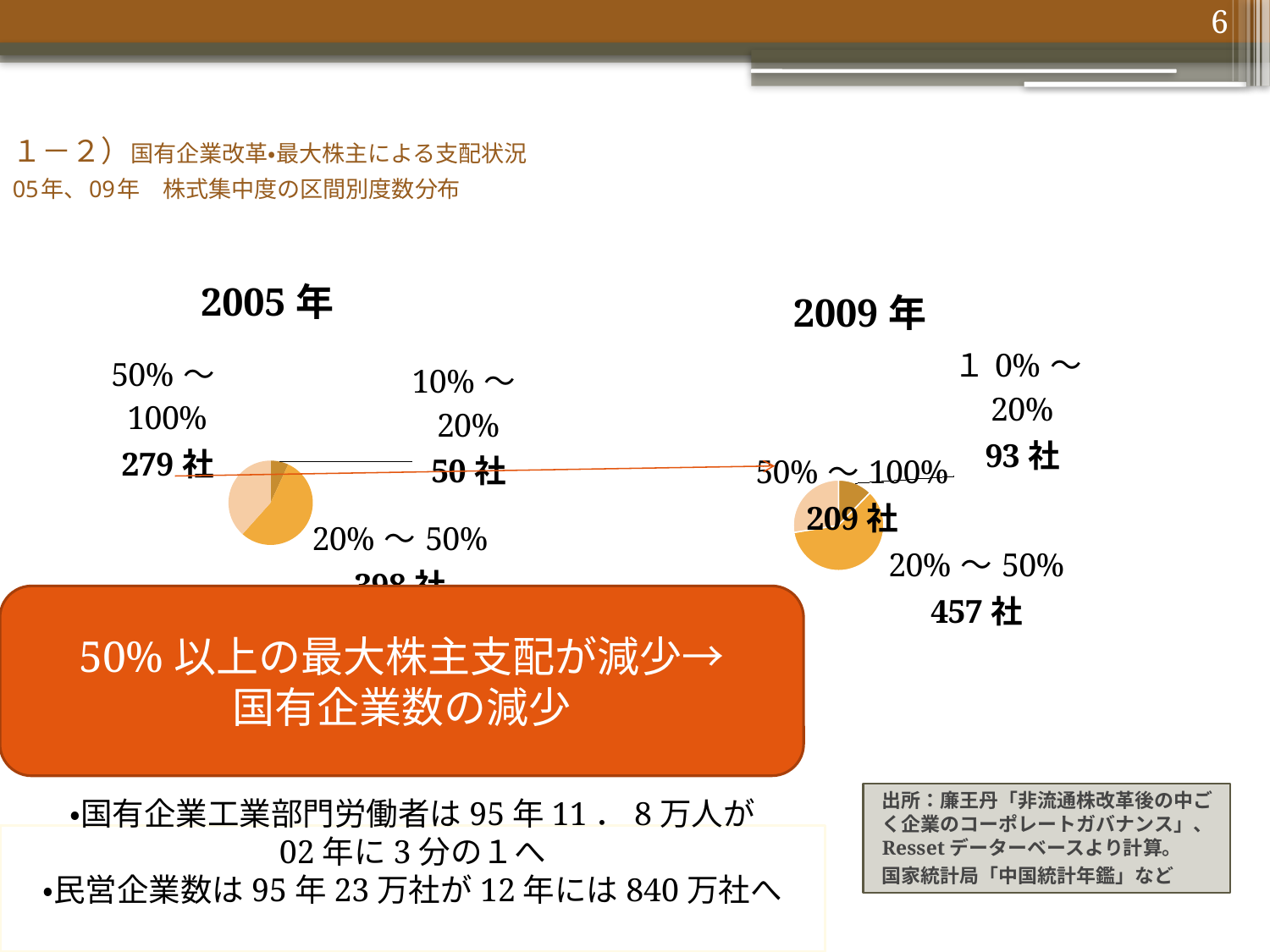
In the 2005年 pie chart, how many companies are in the 50%～100% category? 279社 Which is larger: the 50%～100% category in the 2005年 chart or the 50%～100% category in the 2009年 chart? 2005年 (279社) What kind of chart is used for the 2009年 data? Pie chart In the 2009年 pie chart, which category has the largest number of companies? 20%～50% In the 2005年 pie chart, how many companies are in the 10%～20% category? 50社 In the 2005年 pie chart, which category has the smallest number of companies? 10%～20% In the 2009年 pie chart, what is the difference between the 20%～50% and 50%～100% categories? 248社 In the 2009年 pie chart, how many companies are in the 20%～50% category? 457社 How many categories does the 2009年 pie chart show? 3 In the 2009年 pie chart, how many companies are in the 10%～20% category? 93社 In the 2009年 pie chart, which category has the smallest number of companies? 10%～20% In the 2009年 pie chart, how many companies are in the 50%～100% category? 209社